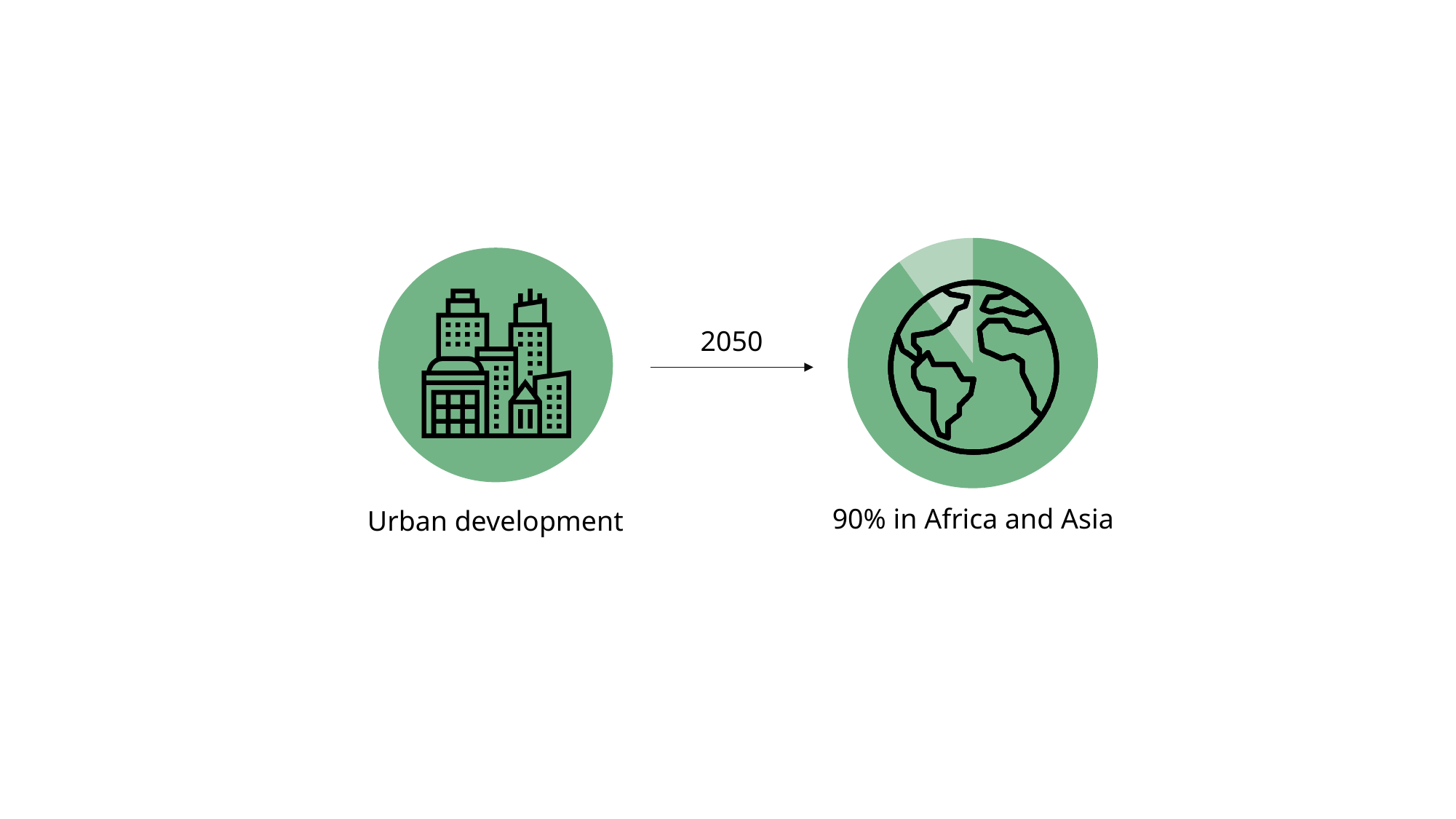
What is the label under the left-hand circle with the city icon? Urban development Is the share shown for Africa and Asia greater or less than 50%? greater What year is written above the arrow between the two circles? 2050 On the right-hand circle, which portion is larger, the dark green or the light green? dark green What share of the right-hand circle does the dark green portion (Africa and Asia) represent? 90% What percentage is shown for Africa and Asia on the right-hand circle? 90% What share of the right-hand circle is not accounted for by Africa and Asia? 10% What kind of chart is the right-hand circle with the globe icon? pie chart